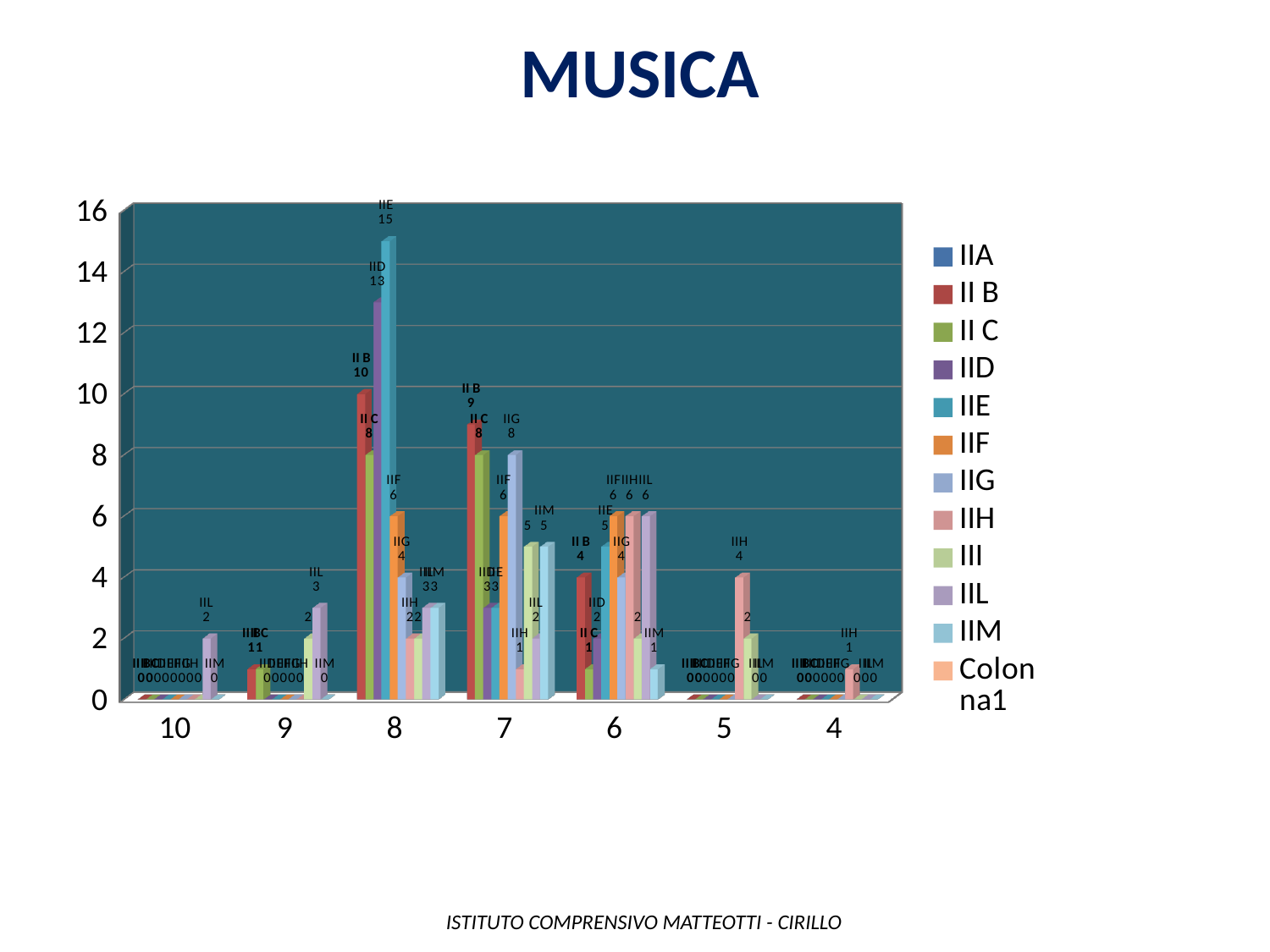
What is the value for IIL in category 10? 2 What is the difference between the IIE value and the IID value in category 8? 2 What is the title of the chart? MUSICA What kind of chart is shown on the slide? bar chart What is the value for IIE in category 8? 15 How many series does the legend list? 12 Which is larger in category 7: the value for IIG or the value for IIF? IIG What is the value for IID in category 8? 13 How many categories are shown on the x axis? 7 What is the value for IIH in category 5? 4 Which series has the highest value in category 8? IIE What is the value for II B in category 7? 9